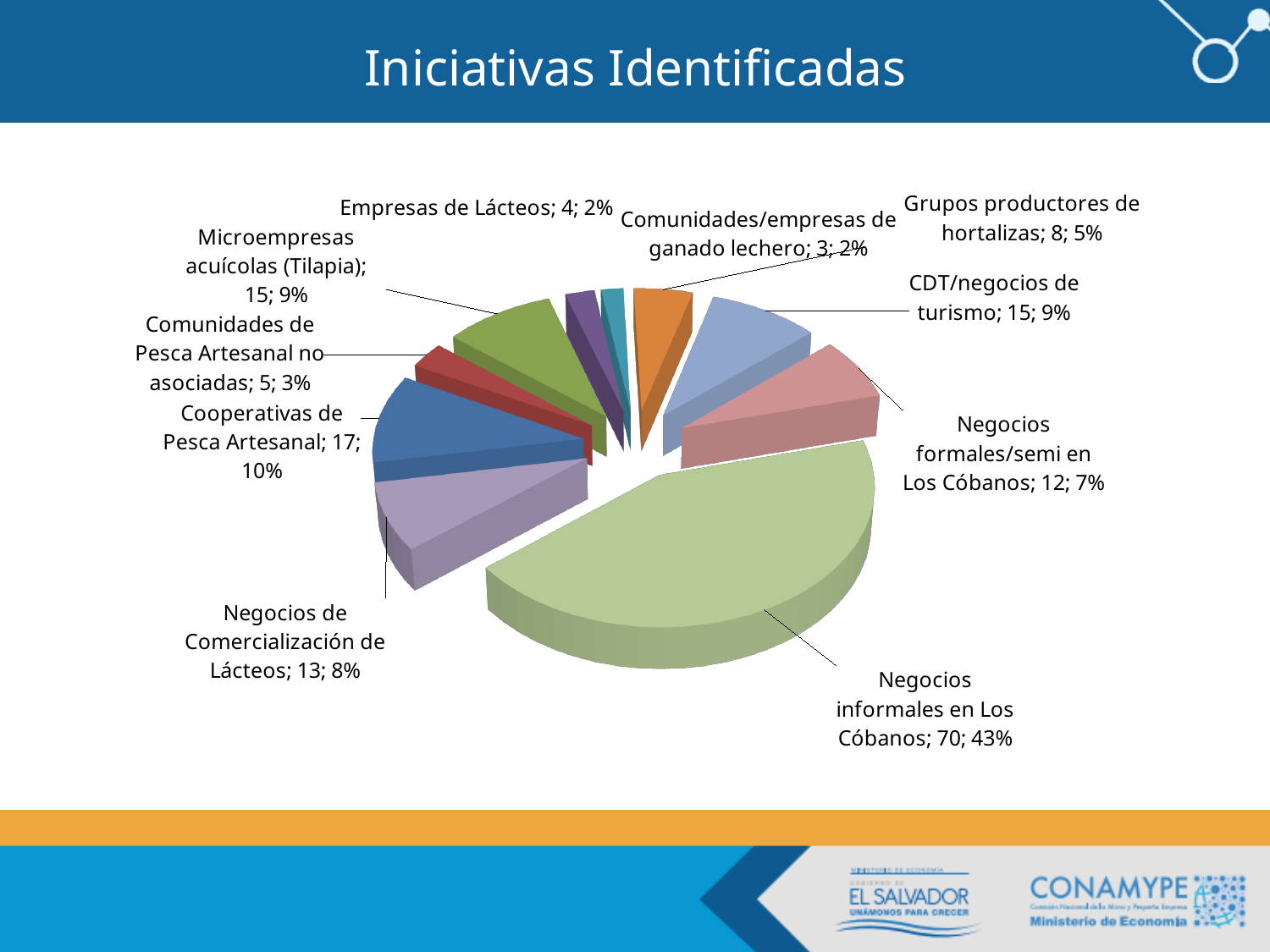
What is the value for Cooperativas de Pesca Artesanal? 17 What kind of chart is shown on the slide? Pie chart What is the value for Negocios informales en Los Cóbanos? 70 Which category has the largest slice of the pie? Negocios informales en Los Cóbanos What is the difference between the values for Negocios informales en Los Cóbanos and Cooperativas de Pesca Artesanal? 53 Which category has the smallest value in the pie chart? Comunidades/empresas de ganado lechero Which is larger, the value for Negocios de Comercialización de Lácteos or the value for Grupos productores de hortalizas? Negocios de Comercialización de Lácteos What share of the pie does Negocios informales en Los Cóbanos represent? 43% What is the value for Comunidades de Pesca Artesanal no asociadas? 5 How many slices does the pie chart have? 10 What is the title of the chart on the slide? Iniciativas Identificadas What share of the pie does CDT/negocios de turismo represent? 9%